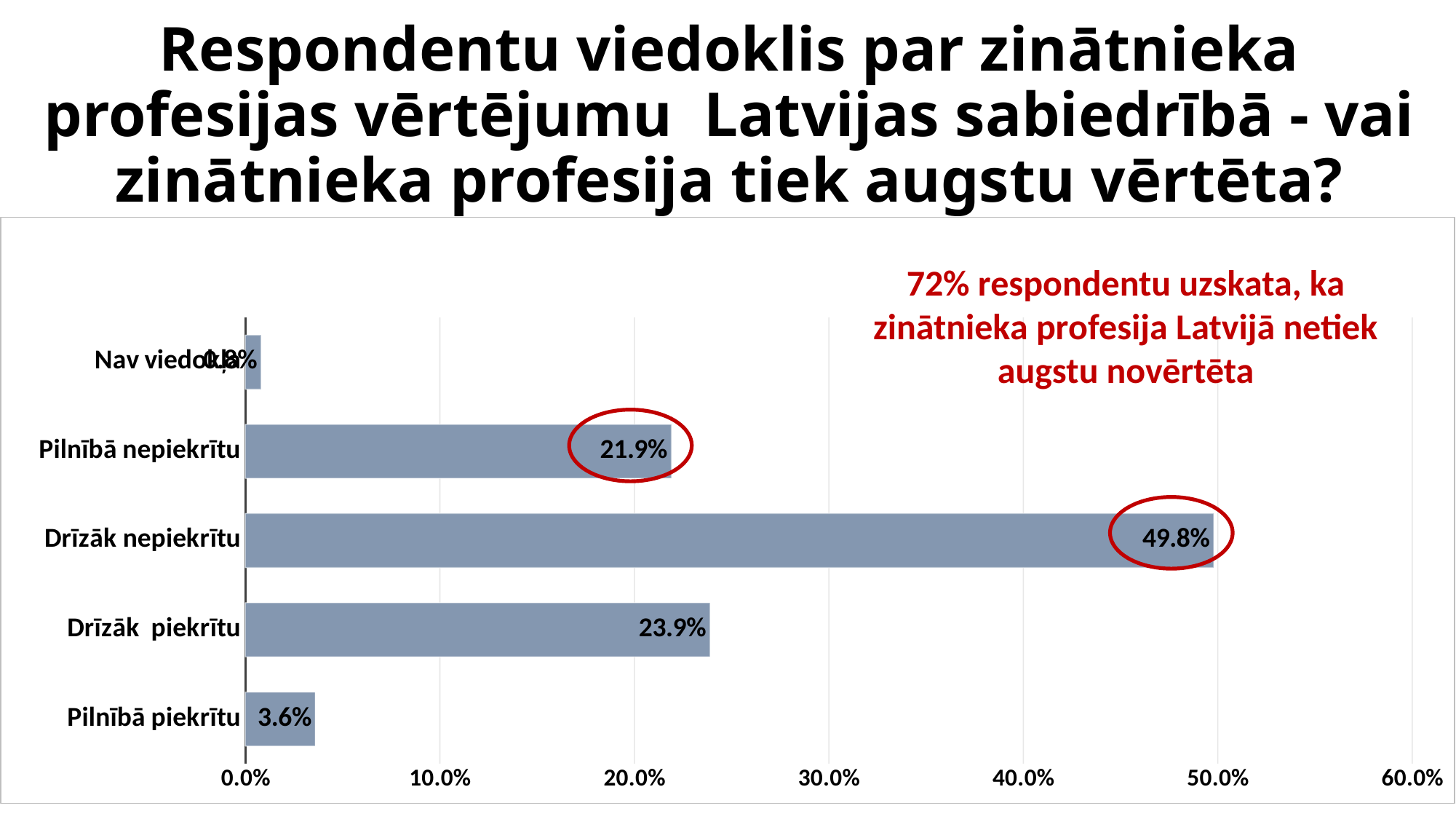
What is the difference between the values for "Drīzāk nepiekrītu" and "Pilnībā nepiekrītu"? 27.9 percentage points Which category has the lowest value? Nav viedokļa What is the value for "Drīzāk nepiekrītu"? 49.8% Is the value for "Nav viedokļa" greater or less than 10.0%? less What is the value for "Drīzāk piekrītu"? 23.9% What kind of chart is shown on the slide? Bar chart According to the red annotation on the chart, what percentage of respondents think the scientist profession is not highly valued in Latvia? 72% What is the value for "Pilnībā piekrītu"? 3.6% How many categories are shown in the chart? 5 What is the value for "Pilnībā nepiekrītu"? 21.9% Which is larger, the value for "Drīzāk piekrītu" or the value for "Pilnībā nepiekrītu"? Drīzāk piekrītu Which category has the highest value? Drīzāk nepiekrītu